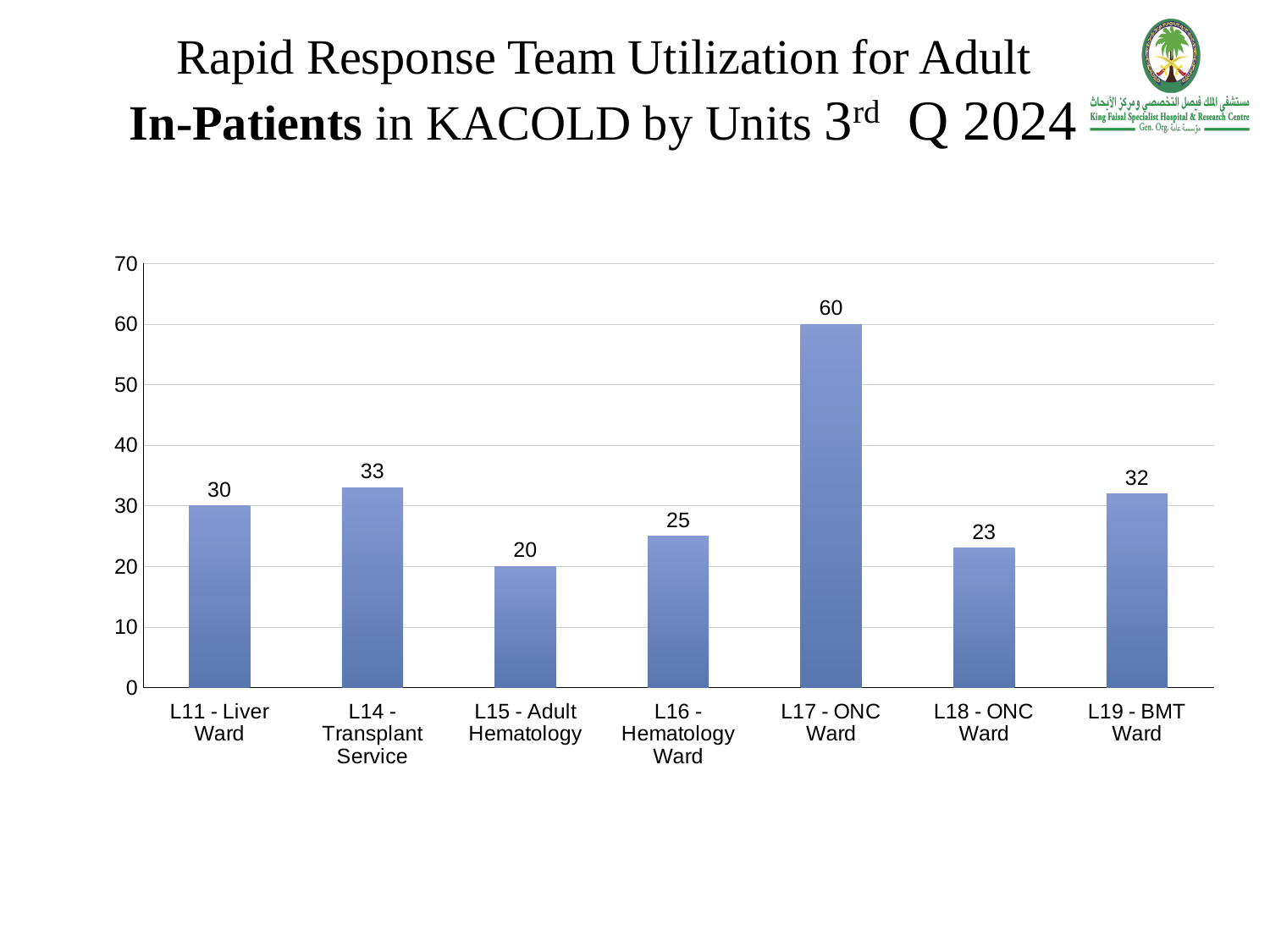
Which is larger, the value for L16 - Hematology Ward or the value for L18 - ONC Ward? L16 - Hematology Ward What is the value for L15 - Adult Hematology? 20 What is the title of the slide? Rapid Response Team Utilization for Adult In-Patients in KACOLD by Units 3rd Q 2024 What is the value for L19 - BMT Ward? 32 How many units are shown on the chart? 7 What kind of chart is shown on the slide? bar chart Which unit has the lowest value? L15 - Adult Hematology Is the value for L17 - ONC Ward greater or less than 50? greater What is the difference between the values for L14 - Transplant Service and L11 - Liver Ward? 3 Which unit has the highest value? L17 - ONC Ward What is the difference between the values for L17 - ONC Ward and L18 - ONC Ward? 37 What is the value for L17 - ONC Ward? 60